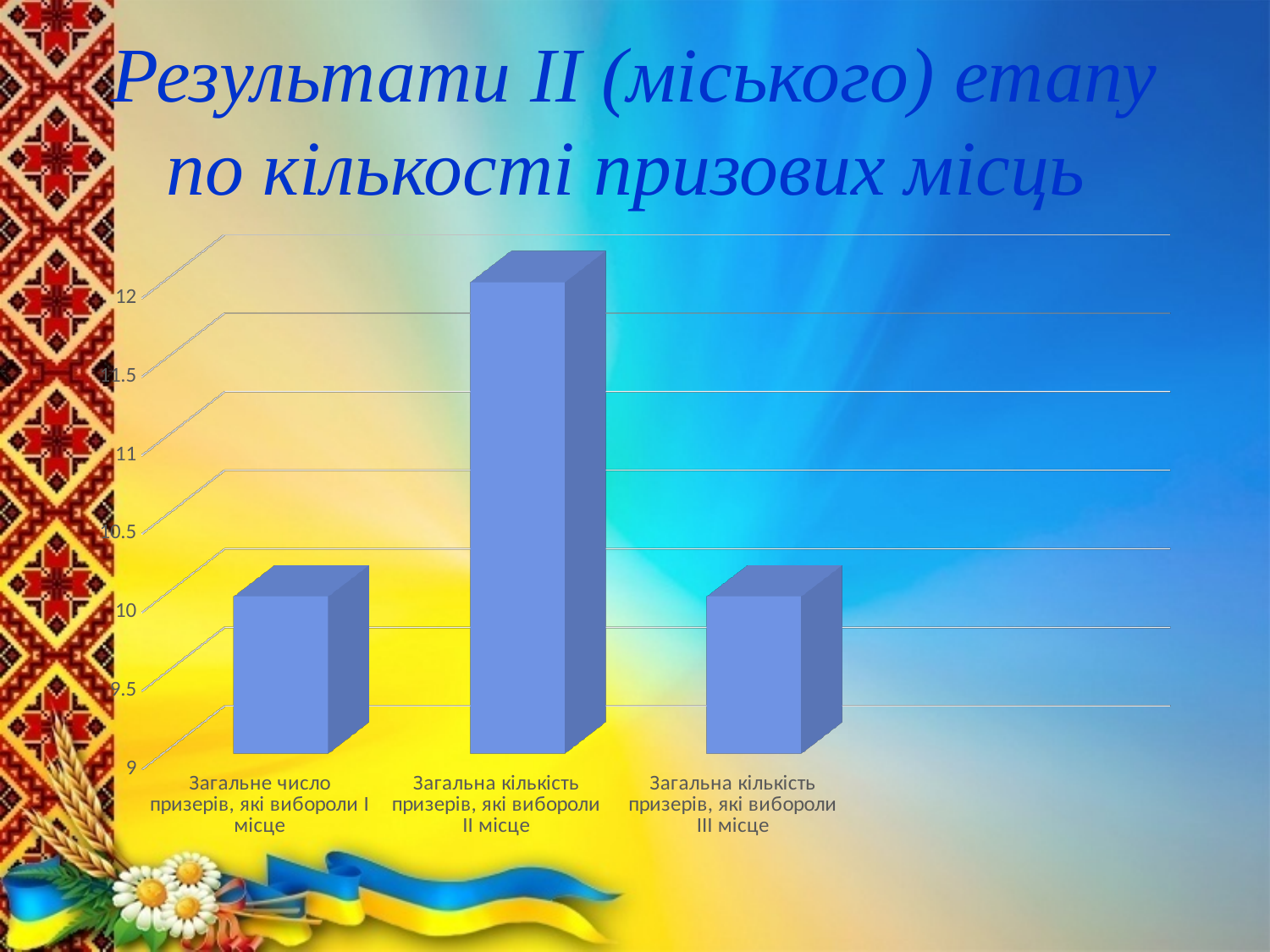
What is the lowest value shown on the vertical axis of the chart? 9 What kind of chart is shown on the slide? bar chart Which is larger: the value for призерів, які вибороли І місце or the value for призерів, які вибороли ІІ місце? призерів, які вибороли ІІ місце Which is larger: the value for призерів, які вибороли ІІ місце or the value for призерів, які вибороли ІІІ місце? призерів, які вибороли ІІ місце Is the value for Загальне число призерів, які вибороли І місце greater or less than 9.5? greater Is the value for Загальна кількість призерів, які вибороли ІІ місце greater or less than 11.5? greater What is the title of the slide containing the chart? Результати ІІ (міського) етапу по кількості призових місць Is the value for Загальне число призерів, які вибороли І місце greater or less than 11? less Which category has the highest bar? Загальна кількість призерів, які вибороли ІІ місце How many categories are plotted in the chart? 3